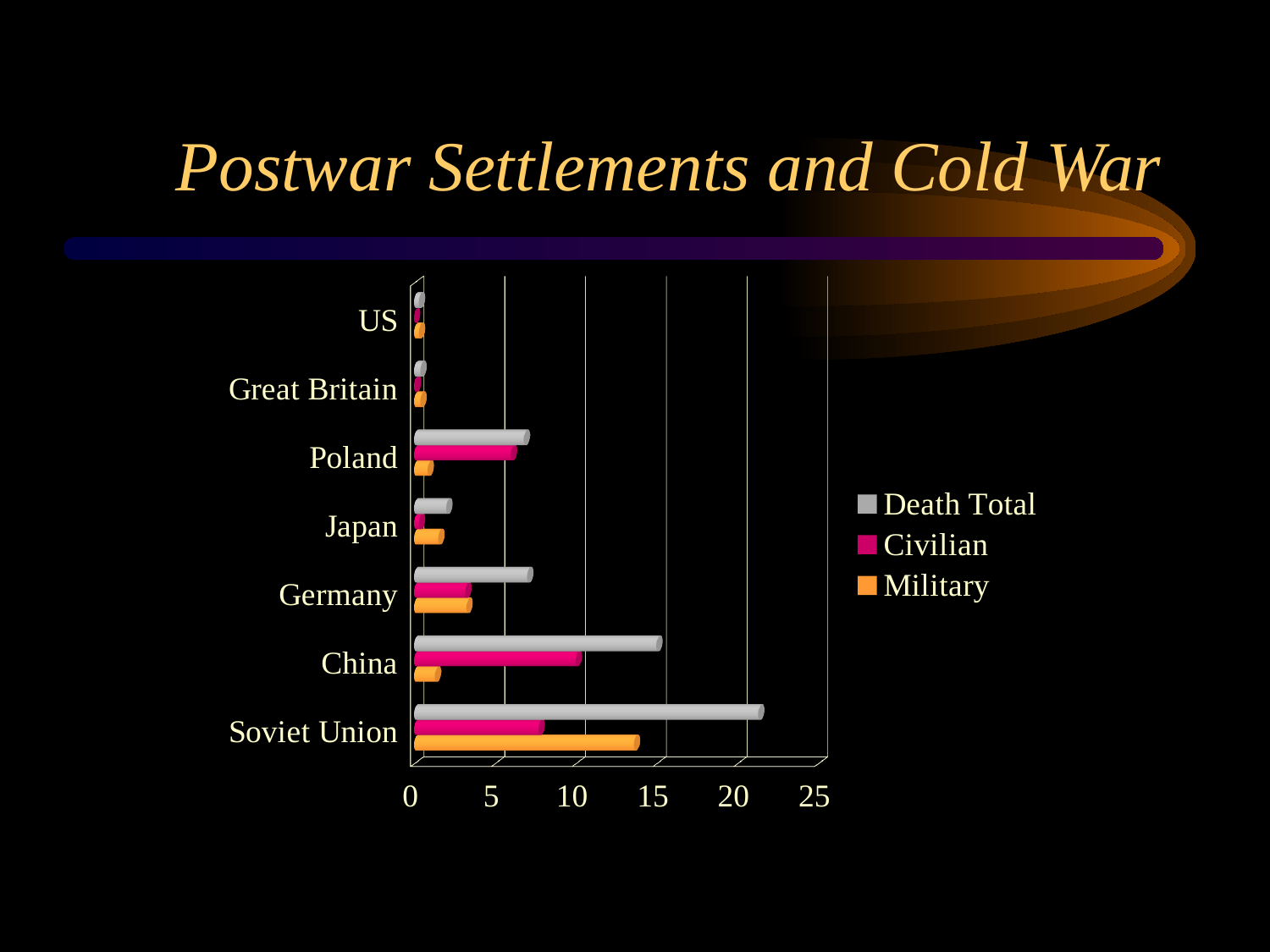
Which is larger for the Soviet Union, the Military bar or the Civilian bar? Military Is the Death Total value for the Soviet Union greater or less than 20? greater Which is larger for China, the Civilian bar or the Military bar? Civilian How many countries are listed on the chart's vertical axis? 7 Is the Military value for the Soviet Union greater or less than 10? greater How many series does the chart's legend list? 3 Which country has the highest Death Total bar? Soviet Union Which country has the highest Military bar? Soviet Union Is the Death Total value for China greater or less than 10? greater Which series is shown in orange in the legend? Military What kind of chart is shown on the slide? Bar chart